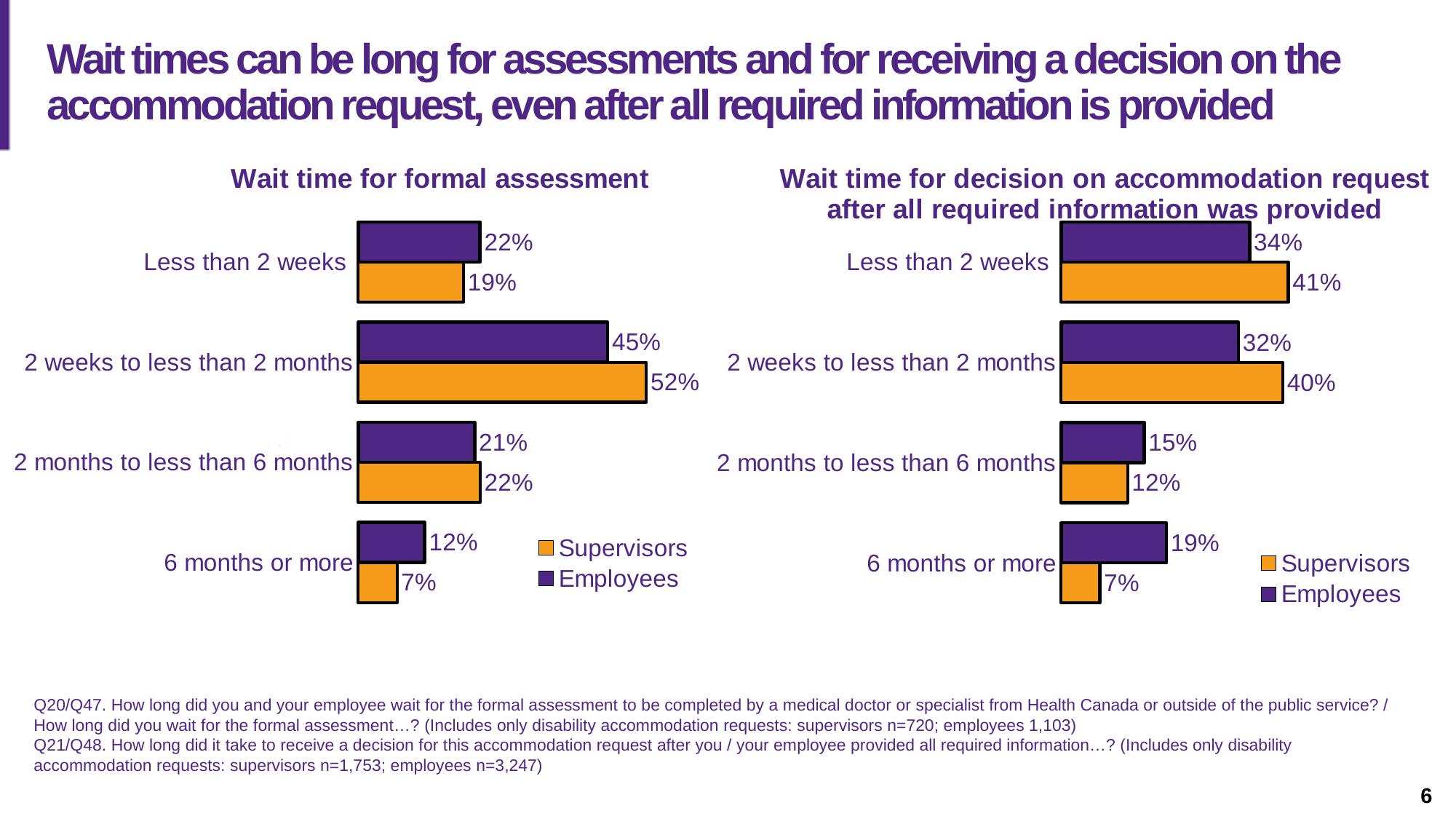
How many categories are shown in the 'Wait time for formal assessment' chart? 4 In the 'Wait time for formal assessment' chart, what is the Employees value for '6 months or more'? 12% In the 'Wait time for decision on accommodation request after all required information was provided' chart, what is the Supervisors value for 'Less than 2 weeks'? 41% In the 'Wait time for formal assessment' chart, what is the Supervisors value for '2 weeks to less than 2 months'? 52% In the 'Wait time for formal assessment' chart, which category has the highest Employees value? 2 weeks to less than 2 months In the 'Wait time for decision on accommodation request after all required information was provided' chart, which category has the lowest Supervisors value? 6 months or more In the 'Wait time for decision on accommodation request after all required information was provided' chart, what is the difference between the Employees and Supervisors values for '6 months or more'? 12% How many series does the legend of the 'Wait time for formal assessment' chart list? 2 In the 'Wait time for decision on accommodation request after all required information was provided' chart, which is larger for '2 weeks to less than 2 months': Supervisors or Employees? Supervisors What type of chart is the 'Wait time for decision on accommodation request after all required information was provided' chart? Bar chart In the 'Wait time for formal assessment' chart, what is the difference between the Supervisors and Employees values for '2 weeks to less than 2 months'? 7% In the 'Wait time for decision on accommodation request after all required information was provided' chart, what is the Employees value for '6 months or more'? 19%